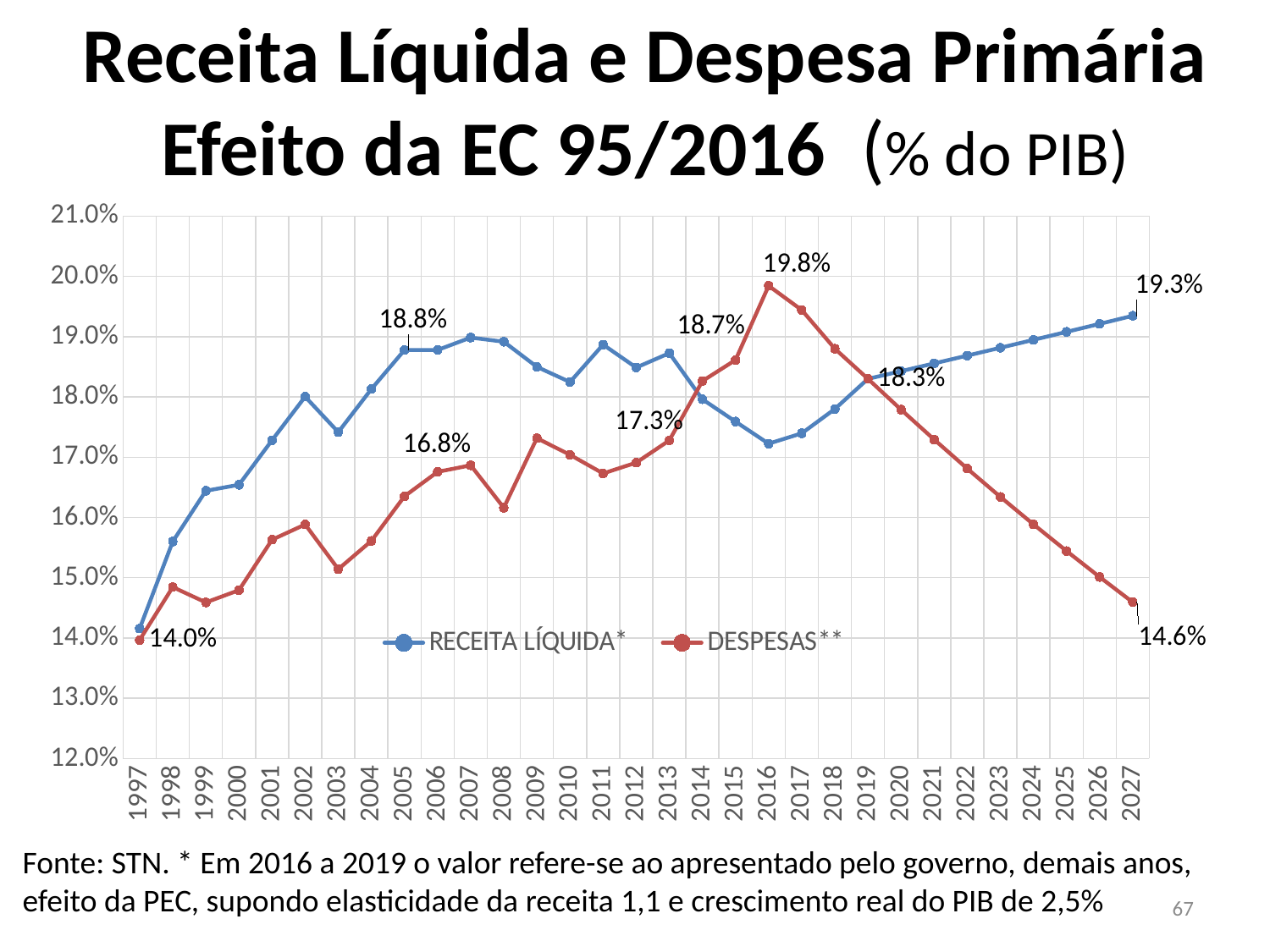
In which year is DESPESAS** at its lowest value? 1997 How many series does the legend list? 2 In 2016, which series has the larger value, RECEITA LÍQUIDA* or DESPESAS**? DESPESAS** What is the value of RECEITA LÍQUIDA* in 2027? 19.3% Is the value of RECEITA LÍQUIDA* in 2003 greater or less than 18.0%? less What is the value of DESPESAS** in 1997? 14.0% What is the difference between RECEITA LÍQUIDA* and DESPESAS** in 2027? 4.7 percentage points What type of chart is shown on the slide? line chart Do the DESPESAS** values rise or fall from 2016 to 2027? fall In which year does DESPESAS** reach its highest value? 2016 What is the value of DESPESAS** in 2027? 14.6% What is the value of DESPESAS** in 2016? 19.8%